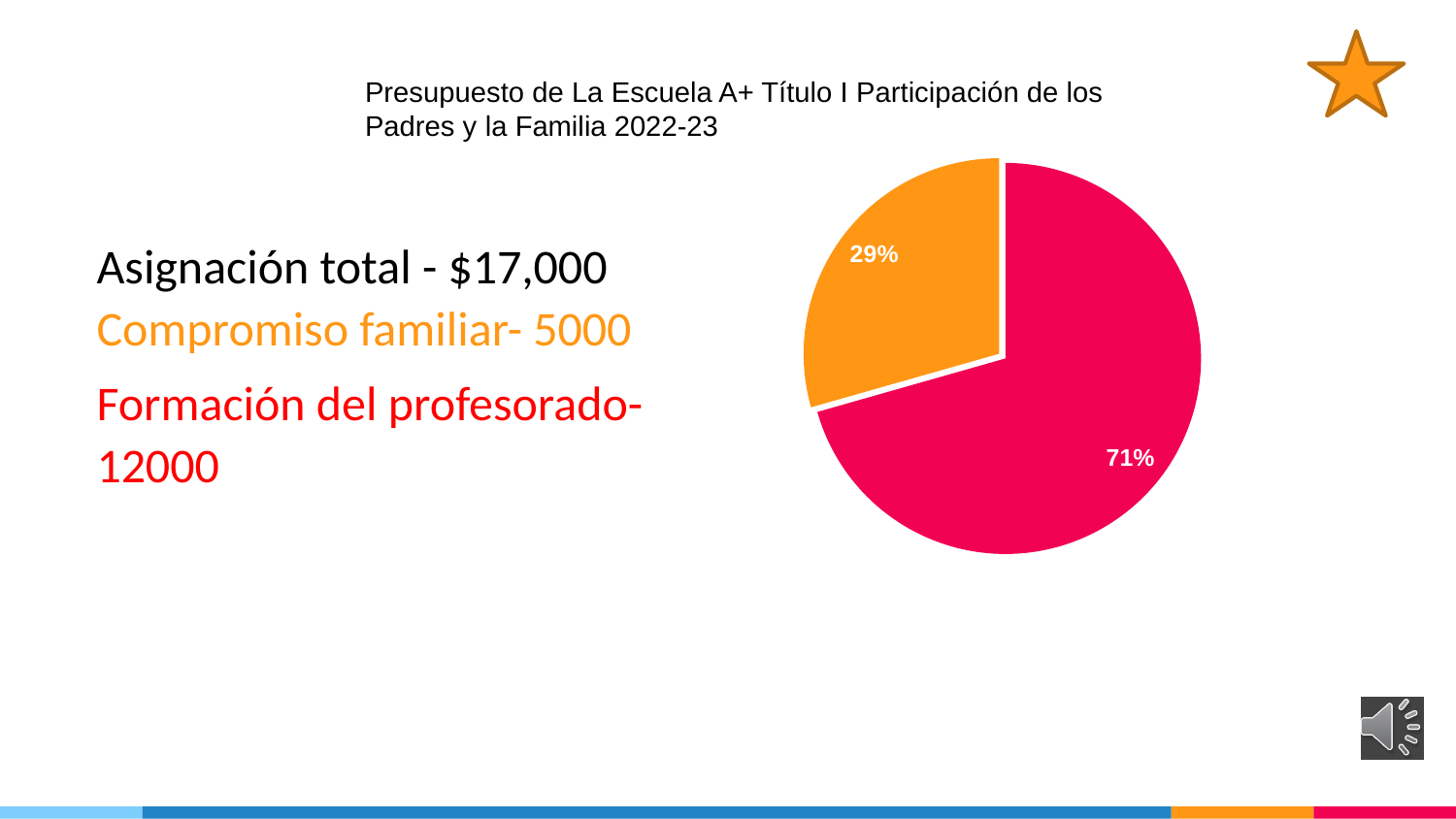
What kind of chart is shown on the slide? pie chart What colour is the slice labelled 71% in the pie chart? red Which slice of the pie chart is the smallest? the orange slice (29%) How many slices does the pie chart have? 2 What is the difference in percentage points between the two slices of the pie chart? 42 Is the red slice of the pie chart larger or smaller than the orange slice? larger What share of the pie does the orange slice represent? 29% What percentage is shown on the orange slice of the pie chart? 29% Which slice of the pie chart is the largest? the red slice (71%) What percentage is shown on the red slice of the pie chart? 71% What is the title shown above the pie chart on the slide? Presupuesto de La Escuela A+ Título I Participación de los Padres y la Familia 2022-23 What share of the pie does the red slice represent? 71%